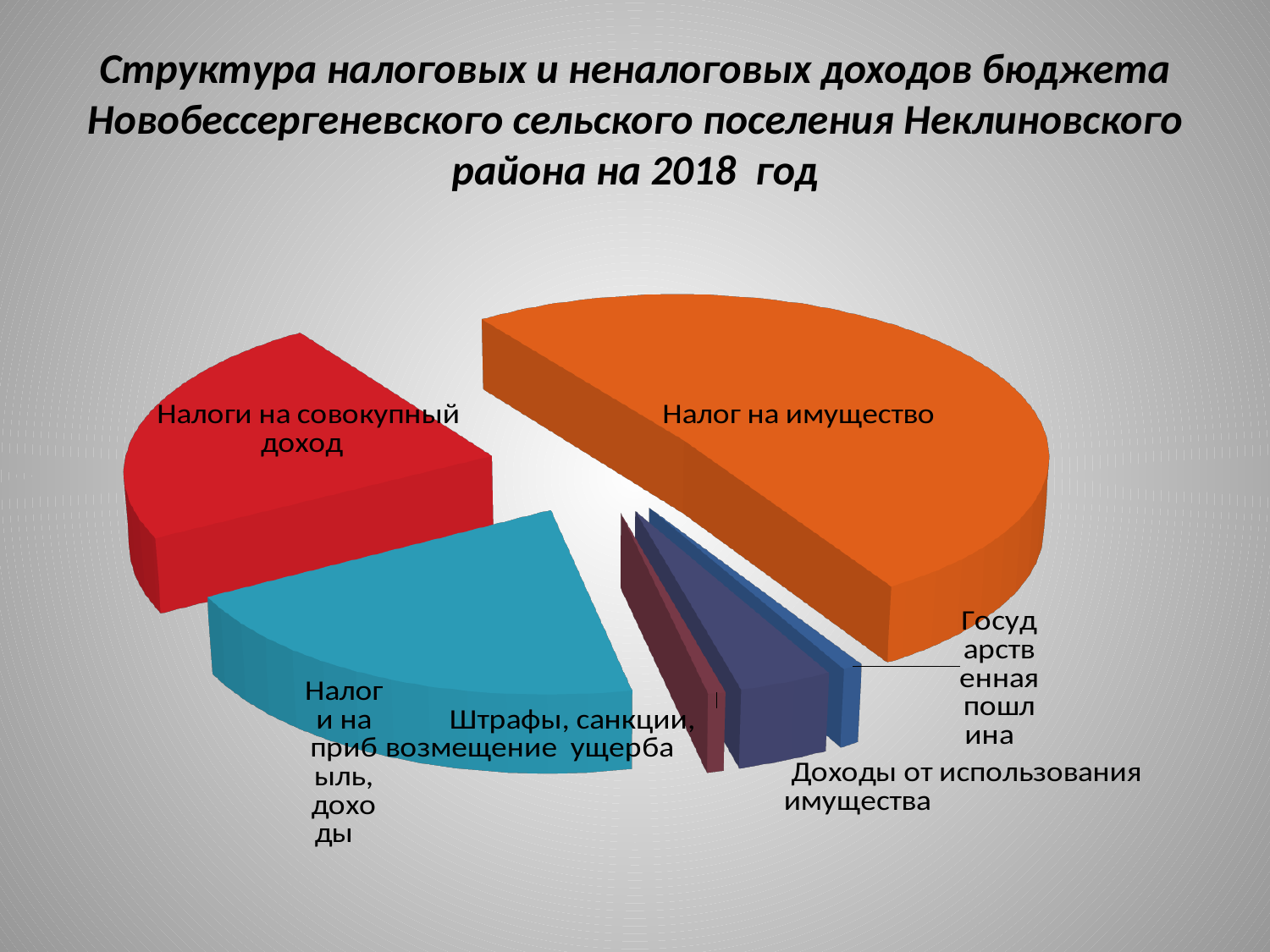
How many slices does the pie chart have? 6 What kind of chart is shown on the slide? pie chart Which is larger: the slice for Налог на имущество or the slice for Доходы от использования имущества? Налог на имущество Which year does the chart title say the budget revenue structure refers to? 2018 Which is larger: the slice for Налог на имущество or the slice for Налог на прибыль, доходы? Налог на имущество What colour is the slice for Налог на имущество? orange Which is larger: the slice for Налог на прибыль, доходы or the slice for Штрафы, санкции, возмещение ущерба? Налог на прибыль, доходы Which category has the largest slice of the pie chart? Налог на имущество